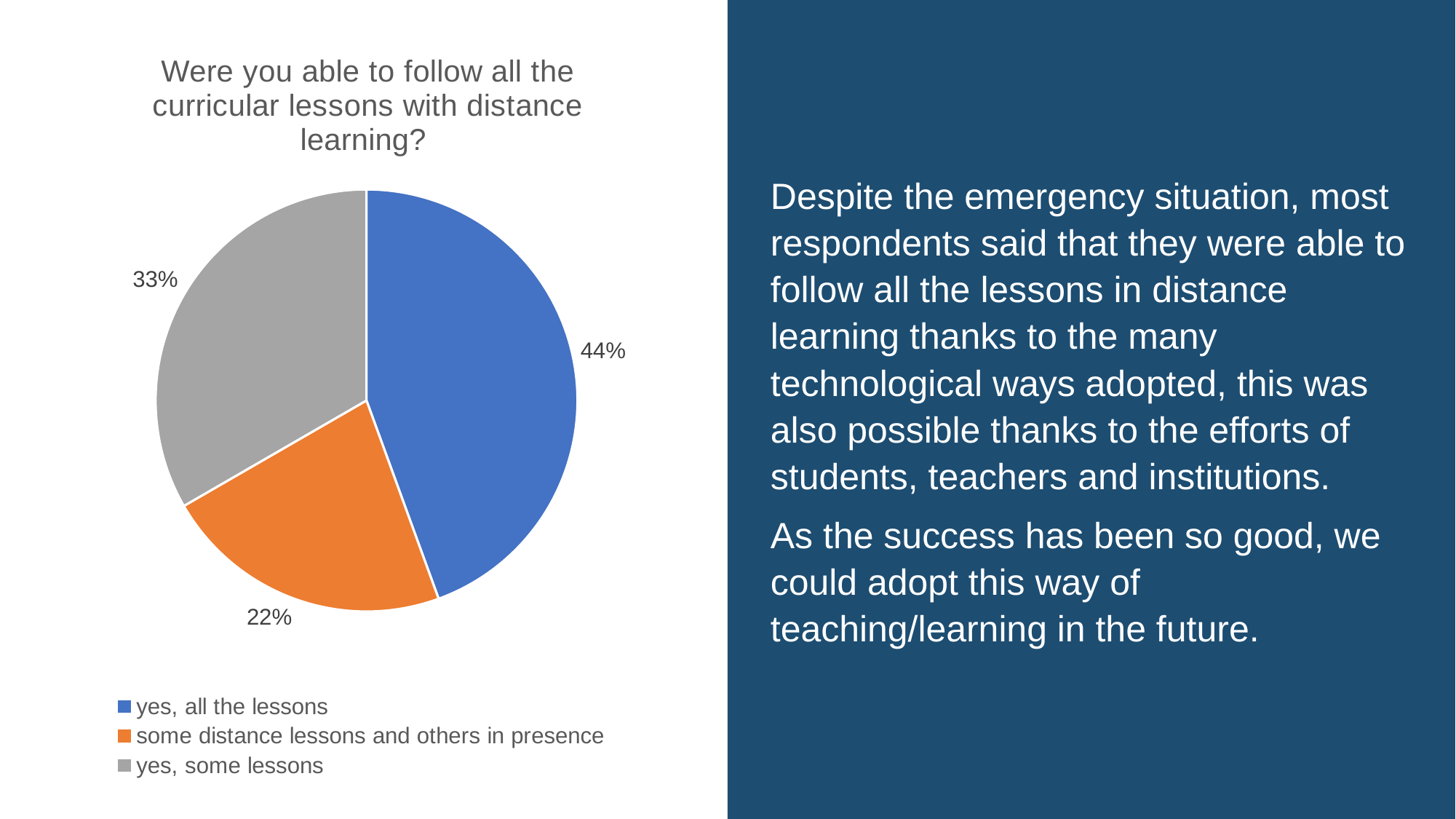
What percentage of respondents answered "some distance lessons and others in presence"? 22% What is the difference in percentage points between "yes, all the lessons" and "yes, some lessons"? 11 Which response has the smallest share of the pie? some distance lessons and others in presence How many slices does the pie chart have? 3 What percentage of respondents answered "yes, all the lessons"? 44% What colour is the slice for "some distance lessons and others in presence"? orange What percentage of respondents answered "yes, some lessons"? 33% What is the title of the chart? Were you able to follow all the curricular lessons with distance learning? Which is larger: the share for "yes, some lessons" or the share for "some distance lessons and others in presence"? yes, some lessons How many entries does the legend list? 3 Which response has the largest share of the pie? yes, all the lessons What type of chart is shown on the slide? pie chart